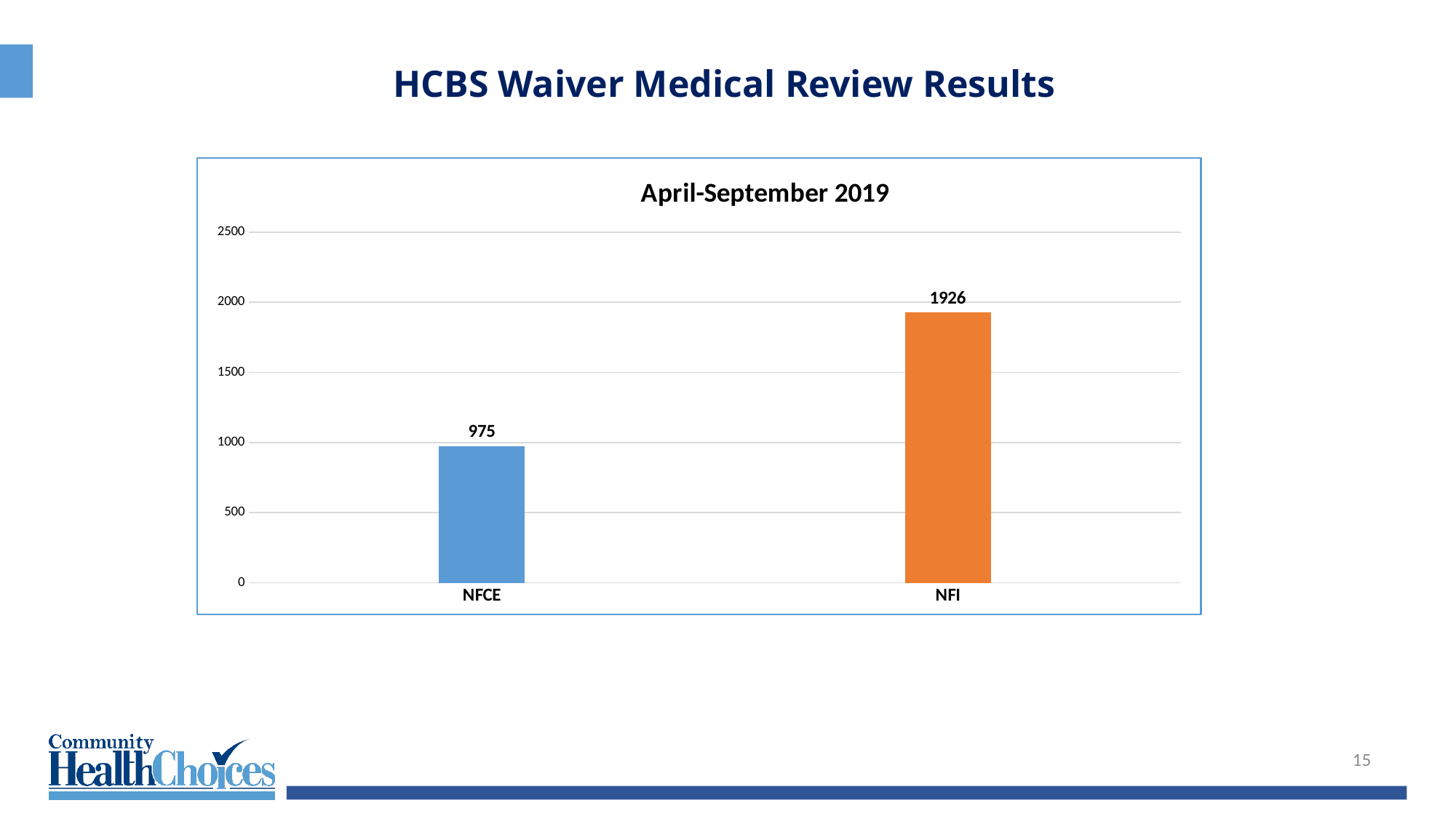
What kind of chart is shown on the slide? bar chart Which category has the highest value? NFI What is the difference between the values for NFI and NFCE? 951 Is the value for NFCE greater or less than 1000? less How many categories are shown on the x axis? 2 What is the value for NFCE? 975 Which category has the lowest value? NFCE Is the value for NFI greater or less than 1500? greater What is the value for NFI? 1926 What colour is the bar for NFI? orange What is the title of the chart? April-September 2019 Which is larger, the value for NFCE or the value for NFI? NFI